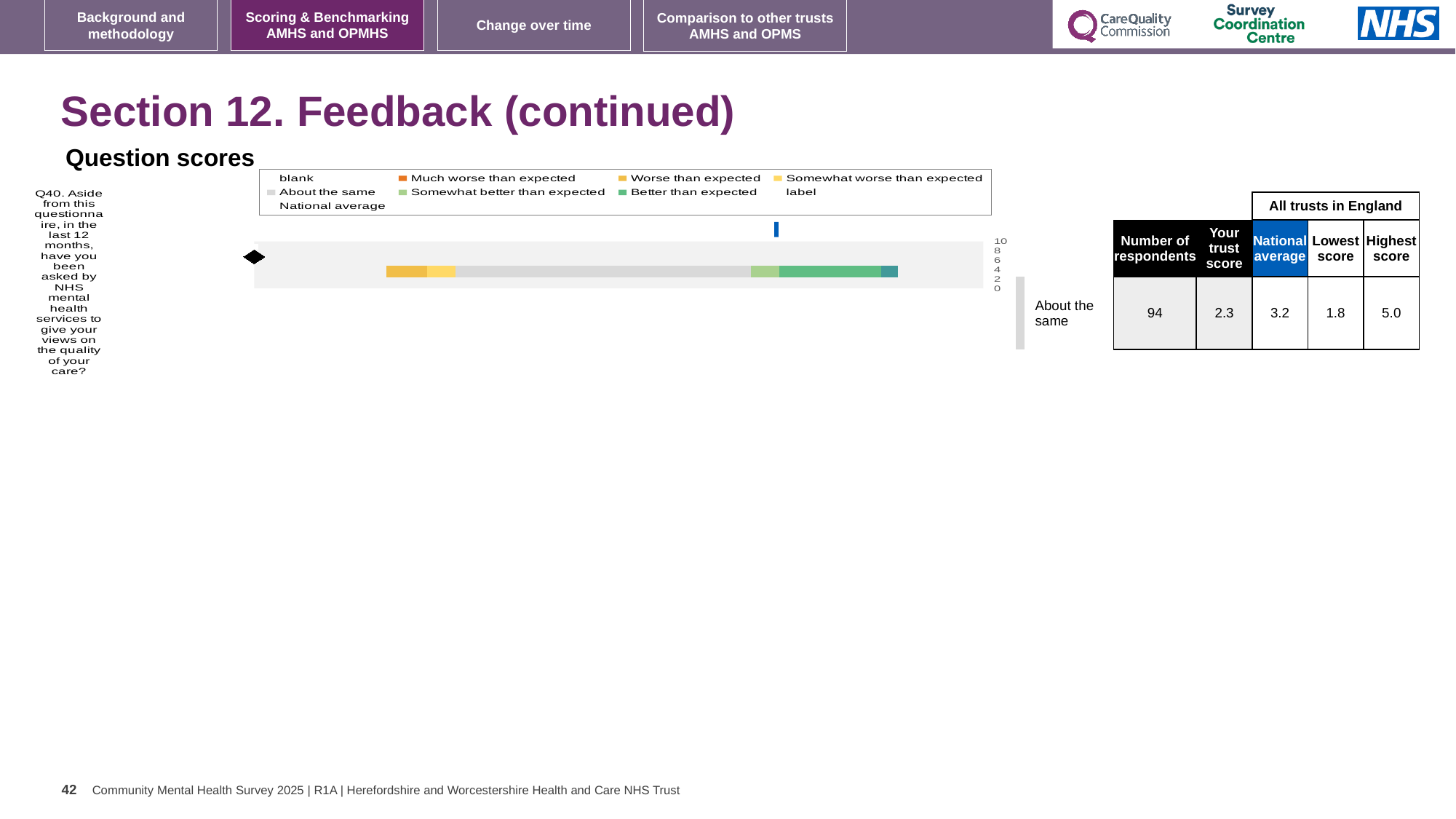
What is the national average score for Q40? 3.2 What kind of chart is used to show the Q40 question score? bar chart For Q40, what is the difference between the highest score and the lowest score among all trusts in England? 3.2 What is the trust's score for Q40? 2.3 Which legend entry in the Question scores chart is shown in orange? Much worse than expected What is the lowest score among all trusts in England for Q40? 1.8 What benchmark category is shown for Q40 next to the chart? About the same What is the highest score among all trusts in England for Q40? 5.0 How many respondents are listed for Q40? 94 For Q40, which is larger: the trust's score or the national average? national average Which legend entry in the Question scores chart is shown in grey? About the same How many questions are plotted in the Question scores chart? 1